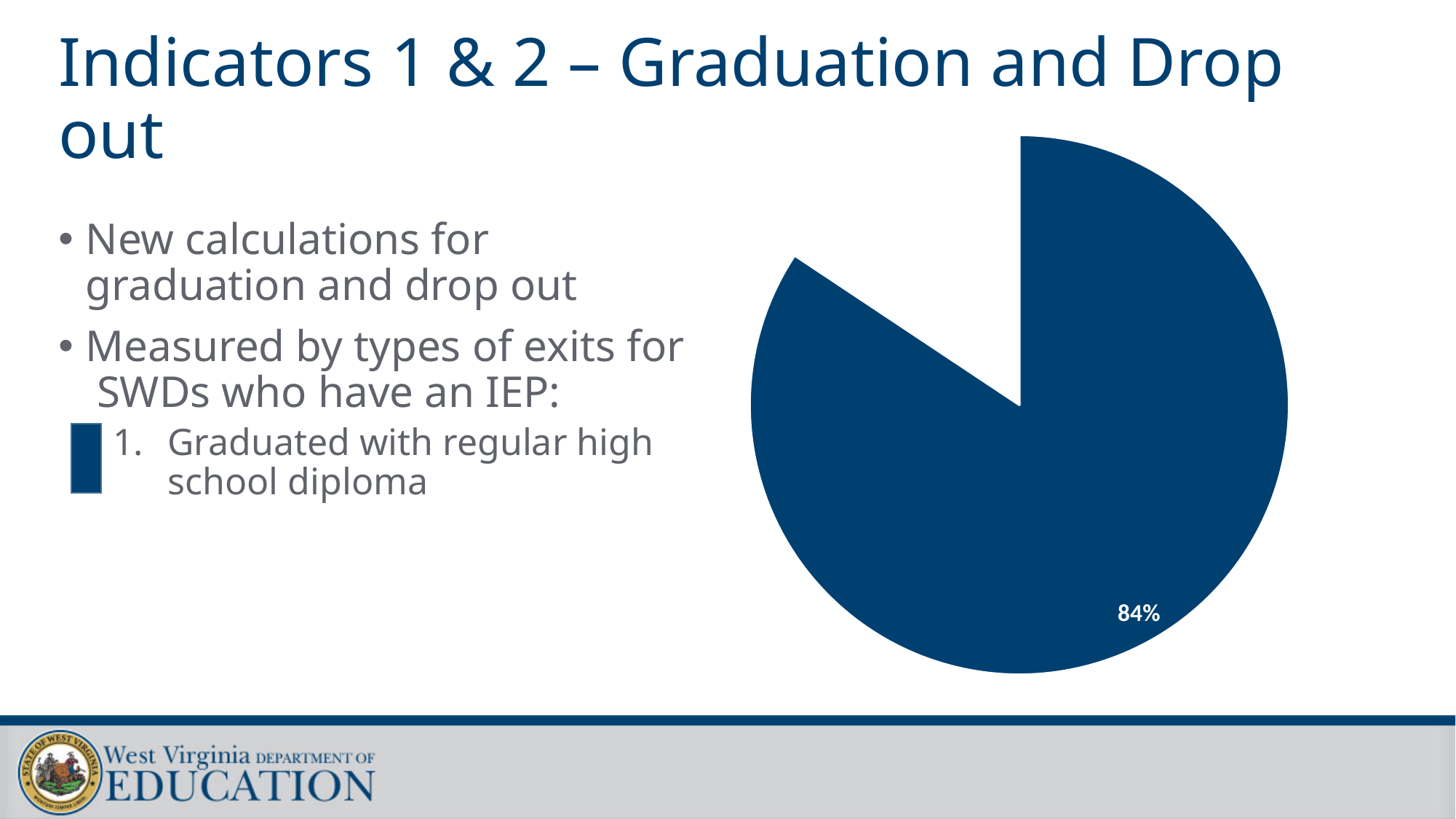
Which exit type does the blue slice of the pie chart correspond to, according to the slide's key? Graduated with regular high school diploma What kind of chart is shown on the slide? pie chart How many data labels are printed on the pie chart? 1 What share of the pie does the slice for 'Graduated with regular high school diploma' represent? 84% Is the value shown on the pie chart slice greater or less than 90%? less What colour is the slice labelled 84% in the pie chart? dark blue What percentage is printed on the blue slice of the pie chart? 84% Is the value shown on the pie chart slice greater or less than 50%? greater